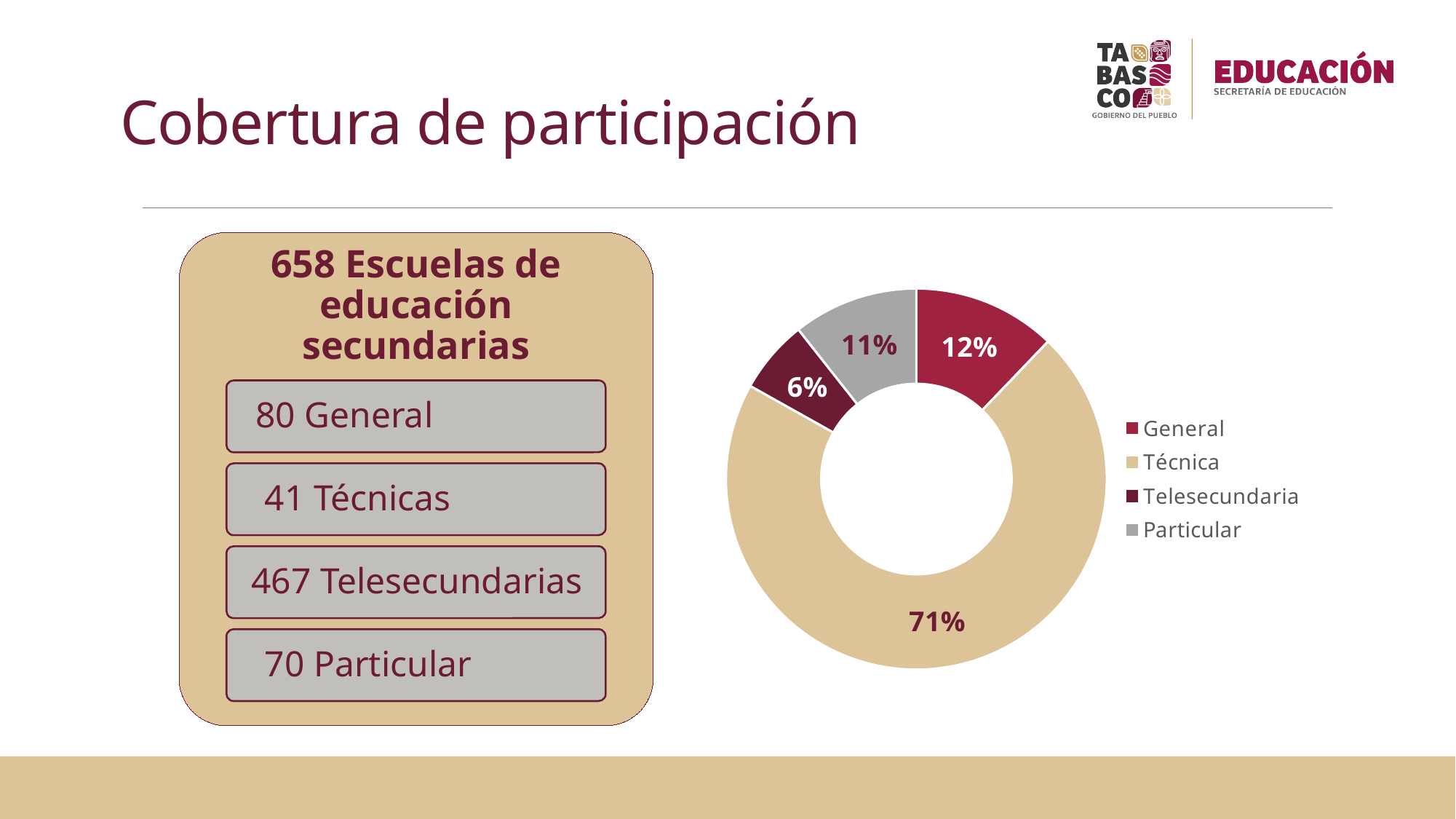
How many slices does the donut chart have? 4 What percentage does the Particular slice show in the donut chart? 11% What colour is the Técnica slice in the donut chart? Tan (beige) Which slice is larger in the donut chart, General or Particular? General How many entries does the legend of the donut chart list? 4 What percentage does the Telesecundaria slice show in the donut chart? 6% What is the difference in percentage points between the Técnica slice and the General slice? 59 What kind of chart is shown on the slide? Donut (pie) chart Which category has the smallest slice in the donut chart? Telesecundaria What percentage does the General slice show in the donut chart? 12% Which category has the largest slice in the donut chart? Técnica What percentage does the Técnica slice show in the donut chart? 71%